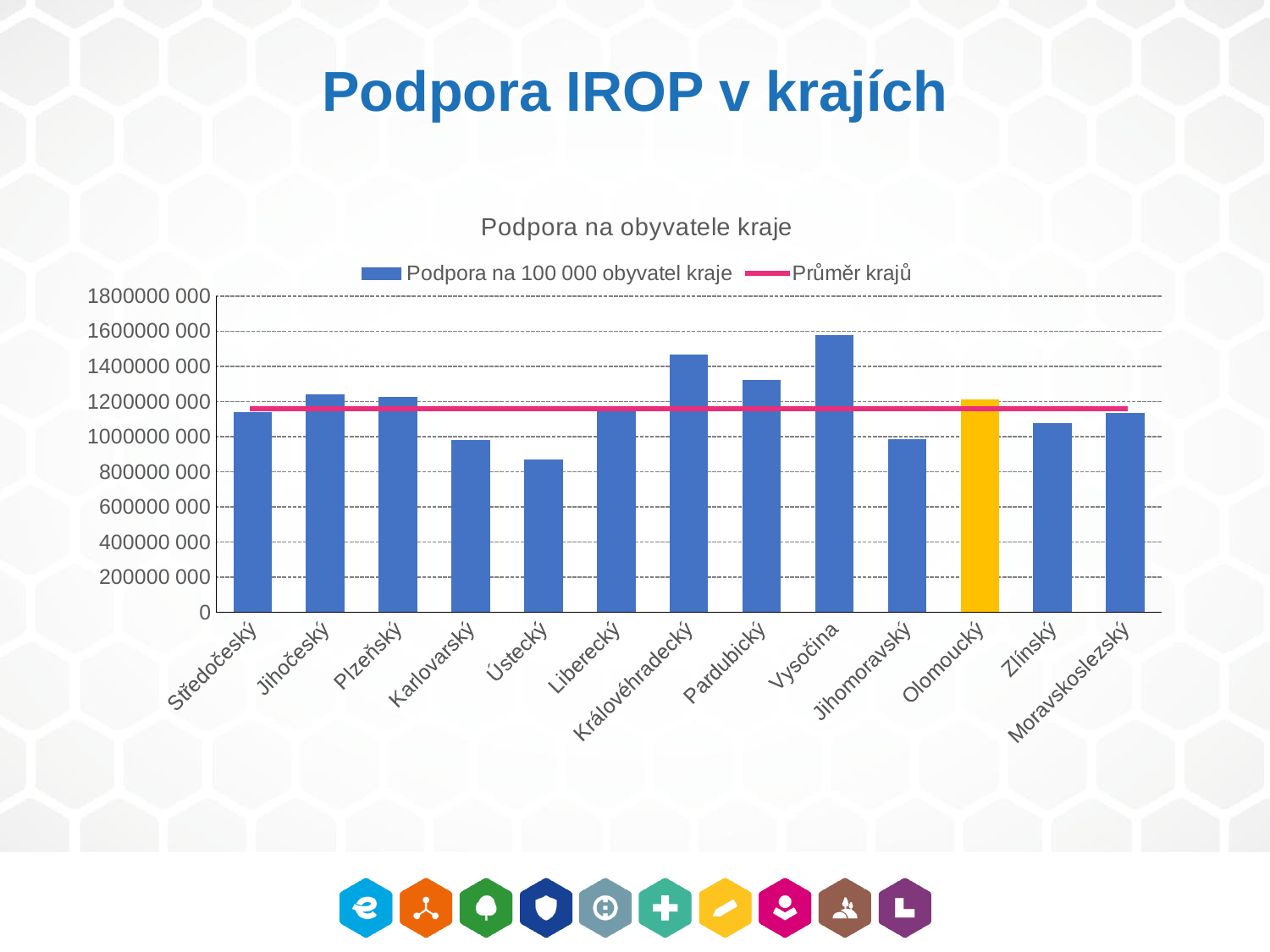
How many series does the chart legend list? 2 How many regions (categories) are shown on the x axis of the chart? 13 What kind of chart is shown on the slide? bar chart Is the value for Ústecký greater or less than 1000000 000? less Which region's bar is highlighted in yellow instead of blue? Olomoucký Is the value for Vysočina greater or less than 1400000 000? greater Is the value for Pardubický greater or less than 1200000 000? greater Which region has the lowest value for Podpora na 100 000 obyvatel kraje? Ústecký Which has the larger value, Jihočeský or Karlovarský? Jihočeský Which region has the highest value for Podpora na 100 000 obyvatel kraje? Vysočina Which has the larger value, Královéhradecký or Pardubický? Královéhradecký